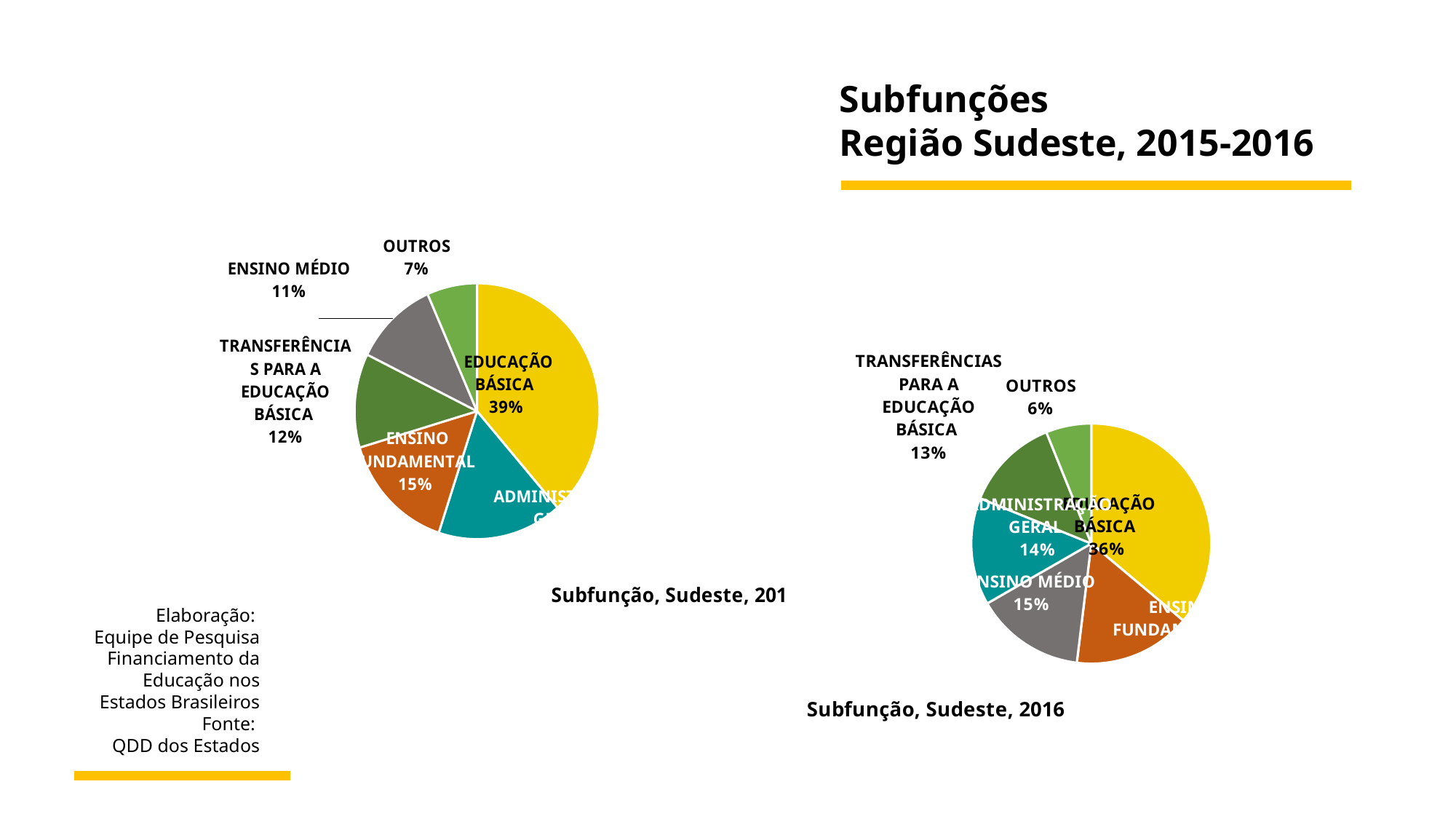
What type of chart is shown on the left side of the slide? Pie chart In the left pie chart, which is larger: ENSINO MÉDIO or TRANSFERÊNCIAS PARA A EDUCAÇÃO BÁSICA? TRANSFERÊNCIAS PARA A EDUCAÇÃO BÁSICA In the left pie chart, what share does OUTROS have? 7% In the left pie chart, what share does EDUCAÇÃO BÁSICA have? 39% In the left pie chart, what share does ENSINO FUNDAMENTAL have? 15% In the chart titled 'Subfunção, Sudeste, 2016', what share does ENSINO MÉDIO have? 15% In the left pie chart, which category has the smallest slice? OUTROS In the chart titled 'Subfunção, Sudeste, 2016', which is larger: ENSINO MÉDIO or ADMINISTRAÇÃO GERAL? ENSINO MÉDIO In the chart titled 'Subfunção, Sudeste, 2016', what is the difference in percentage points between EDUCAÇÃO BÁSICA and OUTROS? 30 percentage points In the left pie chart, which category has the largest slice? EDUCAÇÃO BÁSICA In the chart titled 'Subfunção, Sudeste, 2016', what share does EDUCAÇÃO BÁSICA have? 36% How many slices does the chart titled 'Subfunção, Sudeste, 2016' have? 6